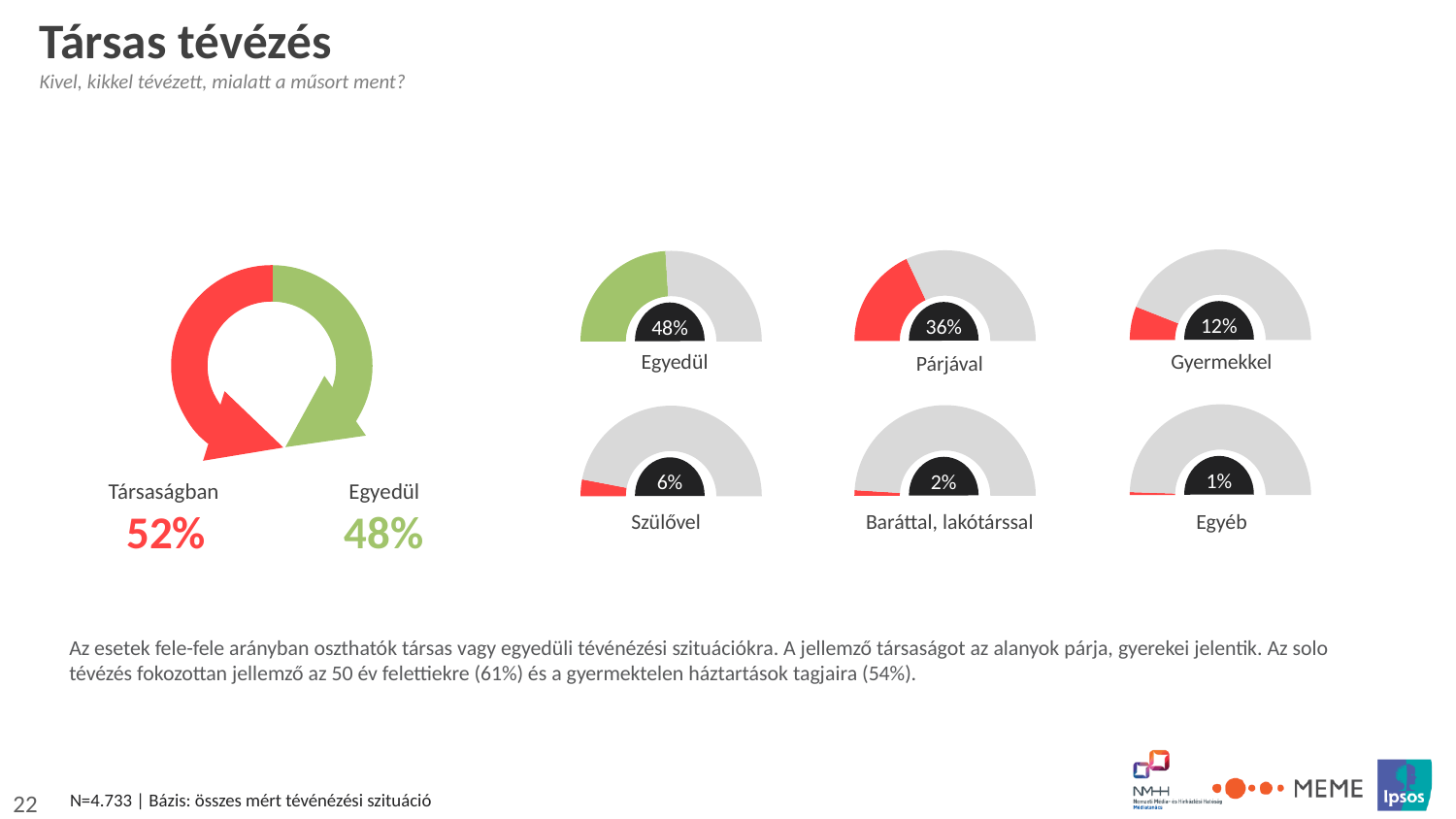
In the gauge charts on the right, what is the value for Gyermekkel? 12% In the gauge charts on the right, what is the value for Baráttal, lakótárssal? 2% In the gauge charts on the right, which category has the highest value? Egyedül How many gauge charts are shown on the right side of the slide? 6 In the donut chart on the left, what is the value for Társaságban? 52% What colour is the Egyedül segment in the donut chart on the left? Green In the gauge charts on the right, what is the difference between Szülővel and Egyéb? 5% In the donut chart on the left, which category is larger, Társaságban or Egyedül? Társaságban In the gauge charts on the right, what is the value for Párjával? 36% In the gauge charts on the right, which category has the lowest value? Egyéb In the donut chart on the left, what is the value for Egyedül? 48% In the donut chart on the left, what is the difference between Társaságban and Egyedül? 4%